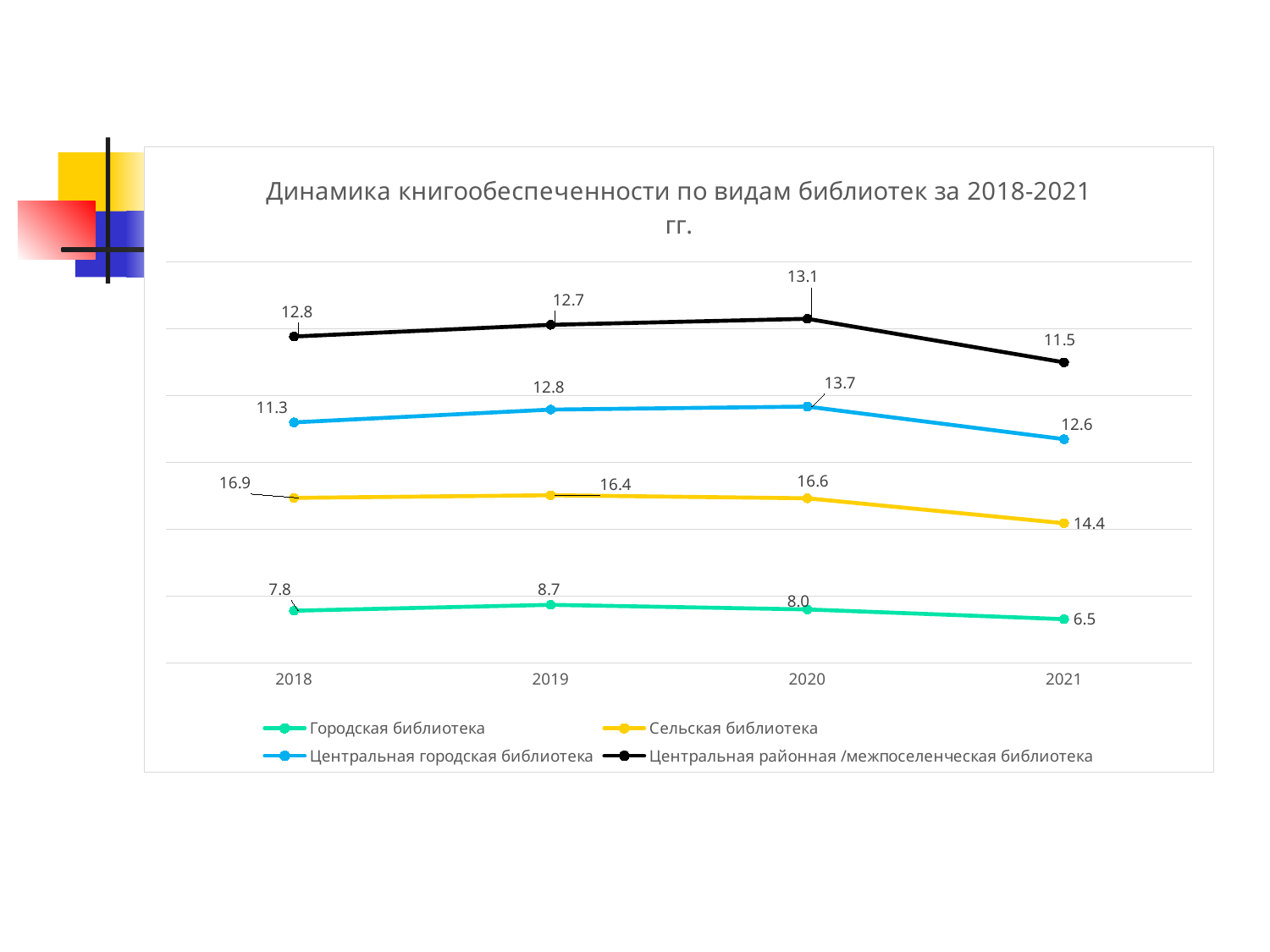
What is the value for Сельская библиотека in 2021? 14.4 How many series does the legend list? 4 What is the value for Городская библиотека in 2019? 8.7 What is the title of the chart? Динамика книгообеспеченности по видам библиотек за 2018-2021 гг. Which is larger in 2021: the value for Центральная городская библиотека or for Центральная районная /межпоселенческая библиотека? Центральная городская библиотека In which year does Городская библиотека have its lowest value? 2021 What is the value for Центральная городская библиотека in 2020? 13.7 How many years are shown on the x axis? 4 What is the difference between the Сельская библиотека values in 2018 and 2021? 2.5 What is the value for Центральная районная /межпоселенческая библиотека in 2018? 12.8 What type of chart is shown on the slide? Line chart In which year does Центральная городская библиотека reach its highest value? 2020